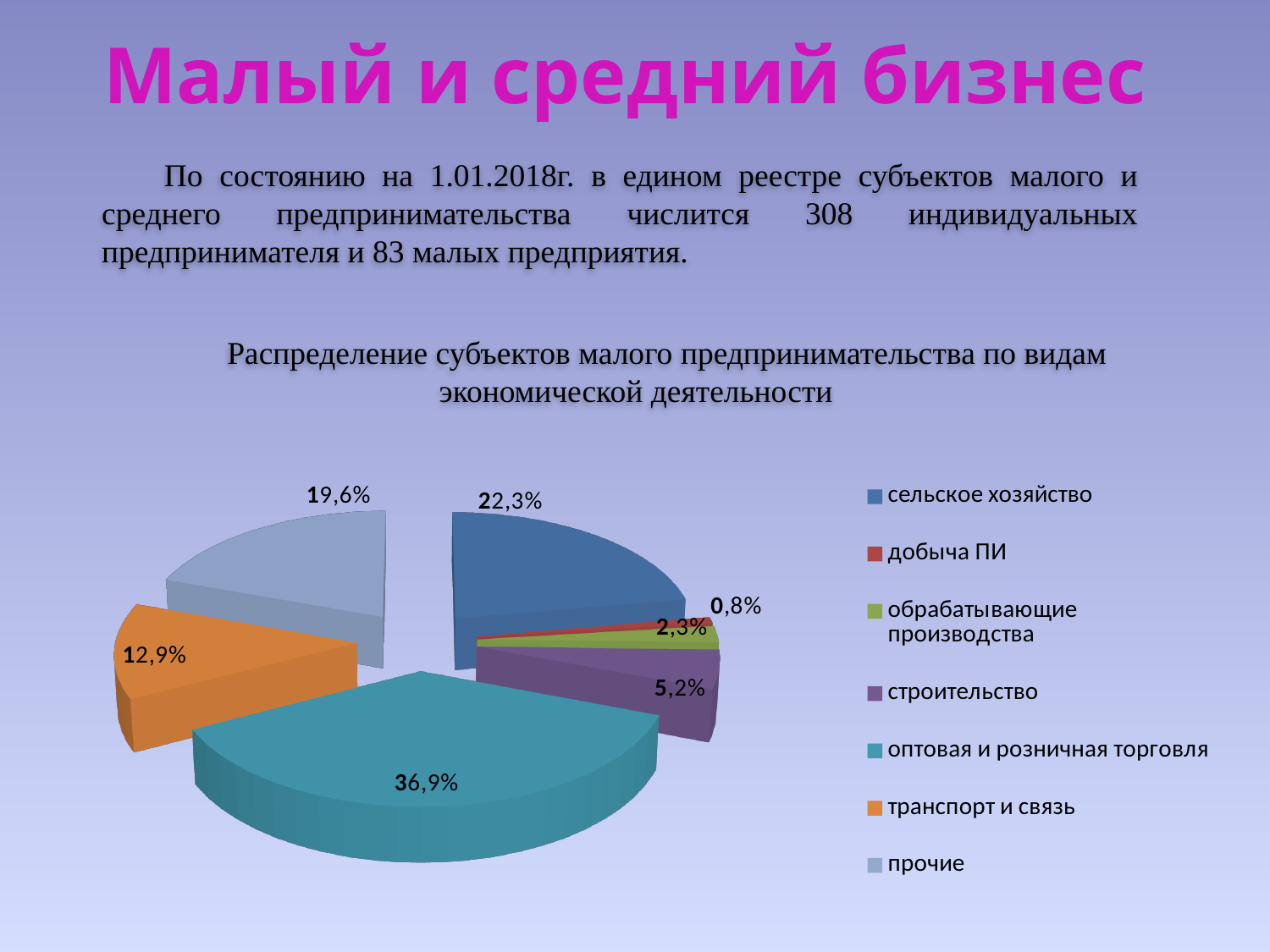
What is the title of the chart? Распределение субъектов малого предпринимательства по видам экономической деятельности What is the difference between the shares of оптовая и розничная торговля and сельское хозяйство? 14,6% What share of the pie does оптовая и розничная торговля hold? 36,9% What is the value shown for сельское хозяйство? 22,3% Which category has the largest slice of the pie? оптовая и розничная торговля What share is shown for строительство? 5,2% How many categories does the pie chart show? 7 What percentage is shown for транспорт и связь? 12,9% What type of chart is shown on the slide? pie chart Which is larger, the share for прочие or the share for транспорт и связь? прочие What is the value for добыча ПИ? 0,8% Which category has the smallest slice of the pie? добыча ПИ